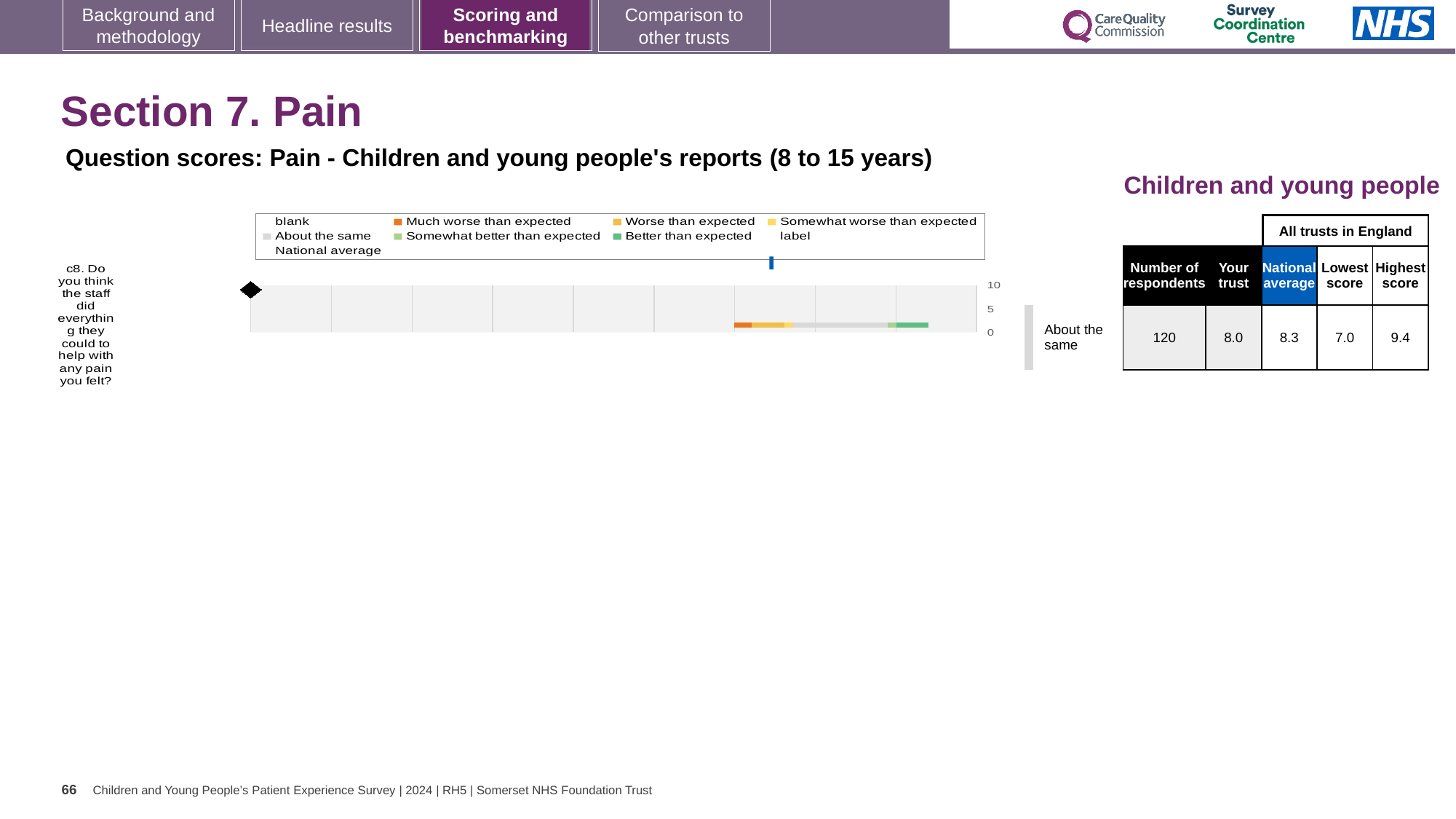
What is the lowest score among all trusts in England for question c8? 7.0 What is the label of the question plotted in the chart? c8. Do you think the staff did everything they could to help with any pain you felt? What colour does the legend use for 'Much worse than expected'? orange What is the national average score for question c8? 8.3 What is the 'Your trust' score for question c8? 8.0 What is the difference between the highest score and the lowest score for question c8? 2.4 How is the trust's result for question c8 categorised relative to expectations? About the same What is the highest score among all trusts in England for question c8? 9.4 How many survey questions are plotted in the chart? 1 How many respondents answered question c8? 120 Which is larger for question c8, the 'Your trust' score or the national average? National average What kind of chart is shown on the slide? bar chart